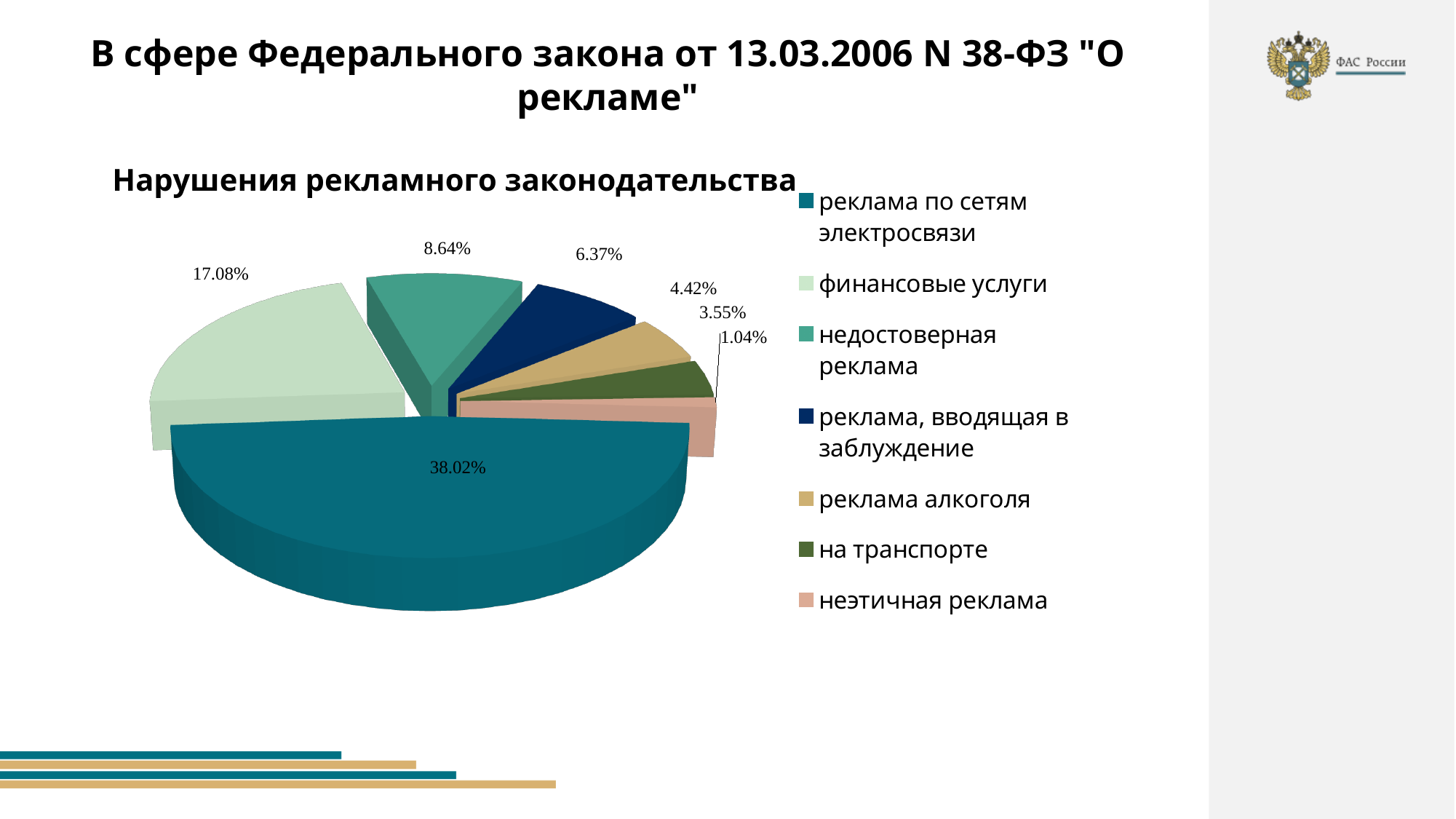
What is the difference between the shares of "финансовые услуги" and "недостоверная реклама"? 8.44% How many categories does the legend of the pie chart list? 7 Which category has the smallest slice of the pie? неэтичная реклама What share of the pie does "реклама по сетям электросвязи" have? 38.02% What is the value shown for "финансовые услуги"? 17.08% What is the value shown for "реклама алкоголя"? 4.42% What is the title of the chart? Нарушения рекламного законодательства What is the value shown for "недостоверная реклама"? 8.64% What type of chart is shown on the slide? pie chart What is the value shown for "реклама, вводящая в заблуждение"? 6.37% Which category has the largest slice of the pie? реклама по сетям электросвязи Which is larger: the share for "на транспорте" or the share for "реклама алкоголя"? реклама алкоголя